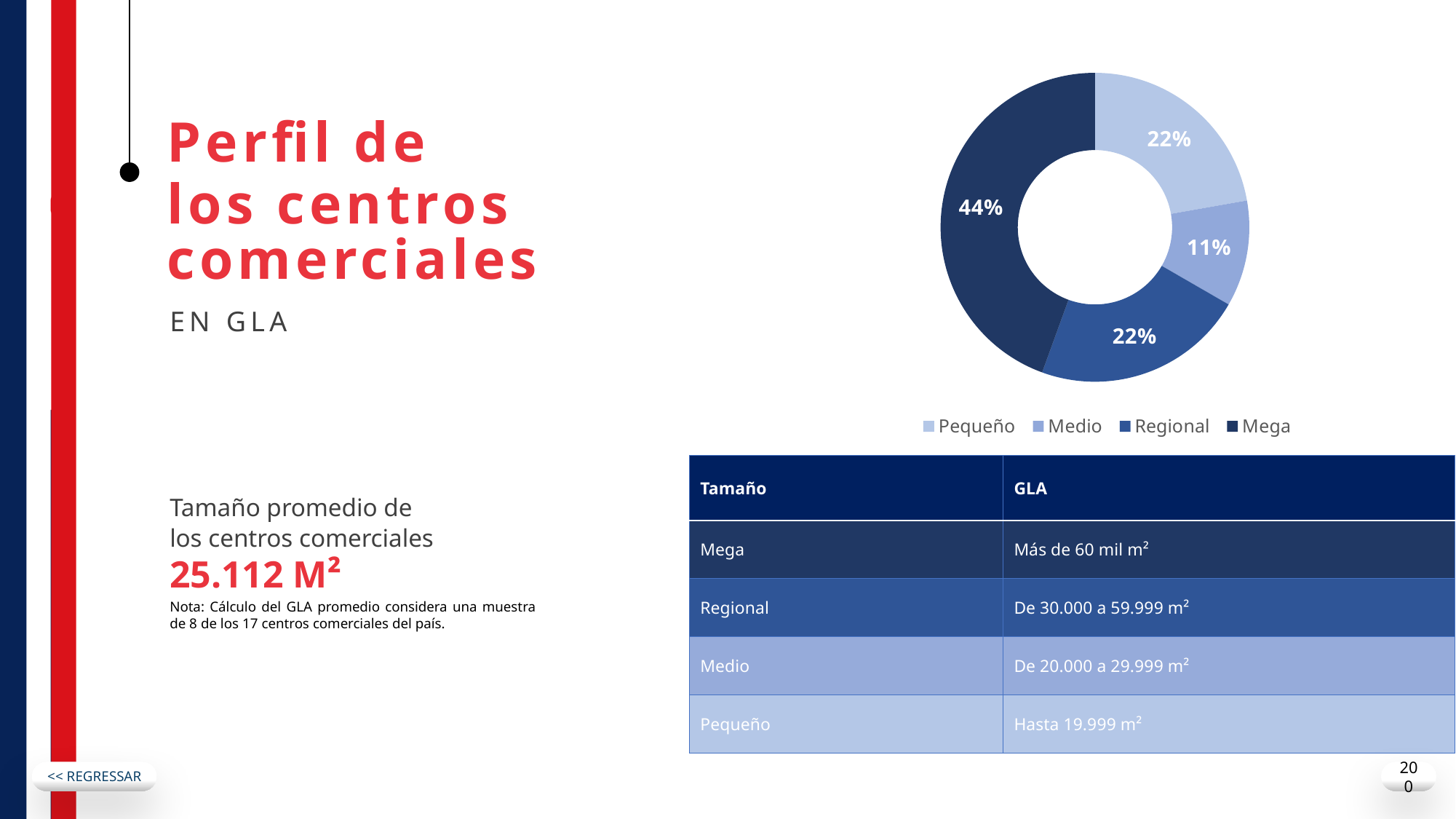
Which is larger in the donut chart, the share for Mega or the share for Regional? Mega How many entries does the legend of the donut chart list? 4 What share of the donut chart does Regional represent? 22% Which category has the smallest share in the donut chart? Medio Which category has the largest share in the donut chart? Mega What kind of chart is shown on the slide? Donut (pie) chart What share of the donut chart does Pequeño represent? 22% What share of the donut chart does Medio represent? 11% What is the difference in percentage points between the Mega and Medio shares? 33 How many categories does the donut chart show? 4 Which legend entry of the donut chart is shown in the darkest blue? Mega What share of the donut chart does Mega represent? 44%